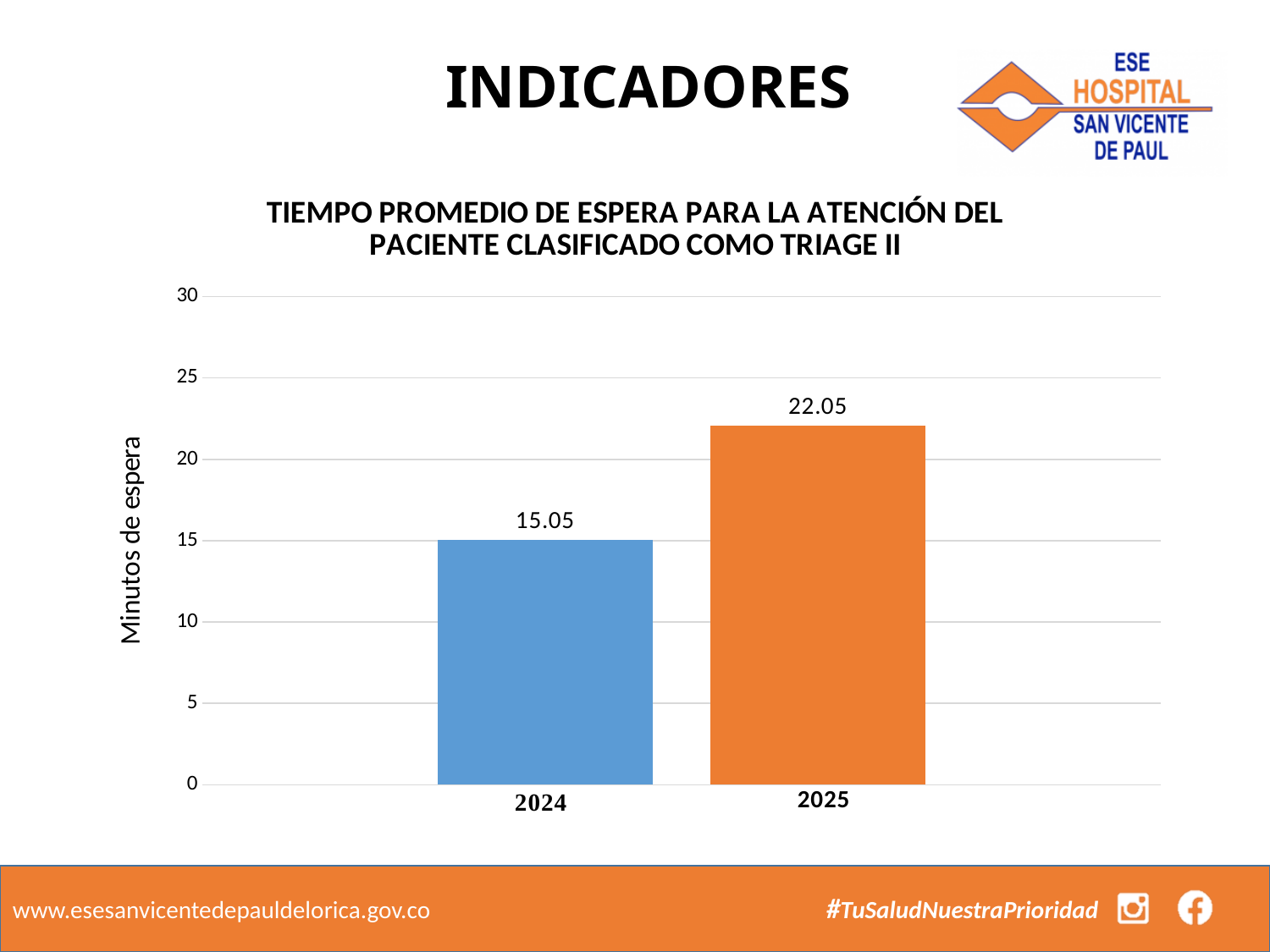
What is the value for 2025? 22.05 Which is larger, the value for 2024 or the value for 2025? 2025 Which year has the highest value? 2025 What is the value for 2024? 15.05 What is the difference between the values for 2025 and 2024? 7 Is the value for 2025 greater or less than 20? greater What kind of chart is shown on the slide? bar chart Which year has the lowest value? 2024 What is the label of the vertical axis? Minutos de espera How many categories are shown on the x axis? 2 Is the value for 2024 greater or less than 20? less Do the values rise or fall from 2024 to 2025? rise